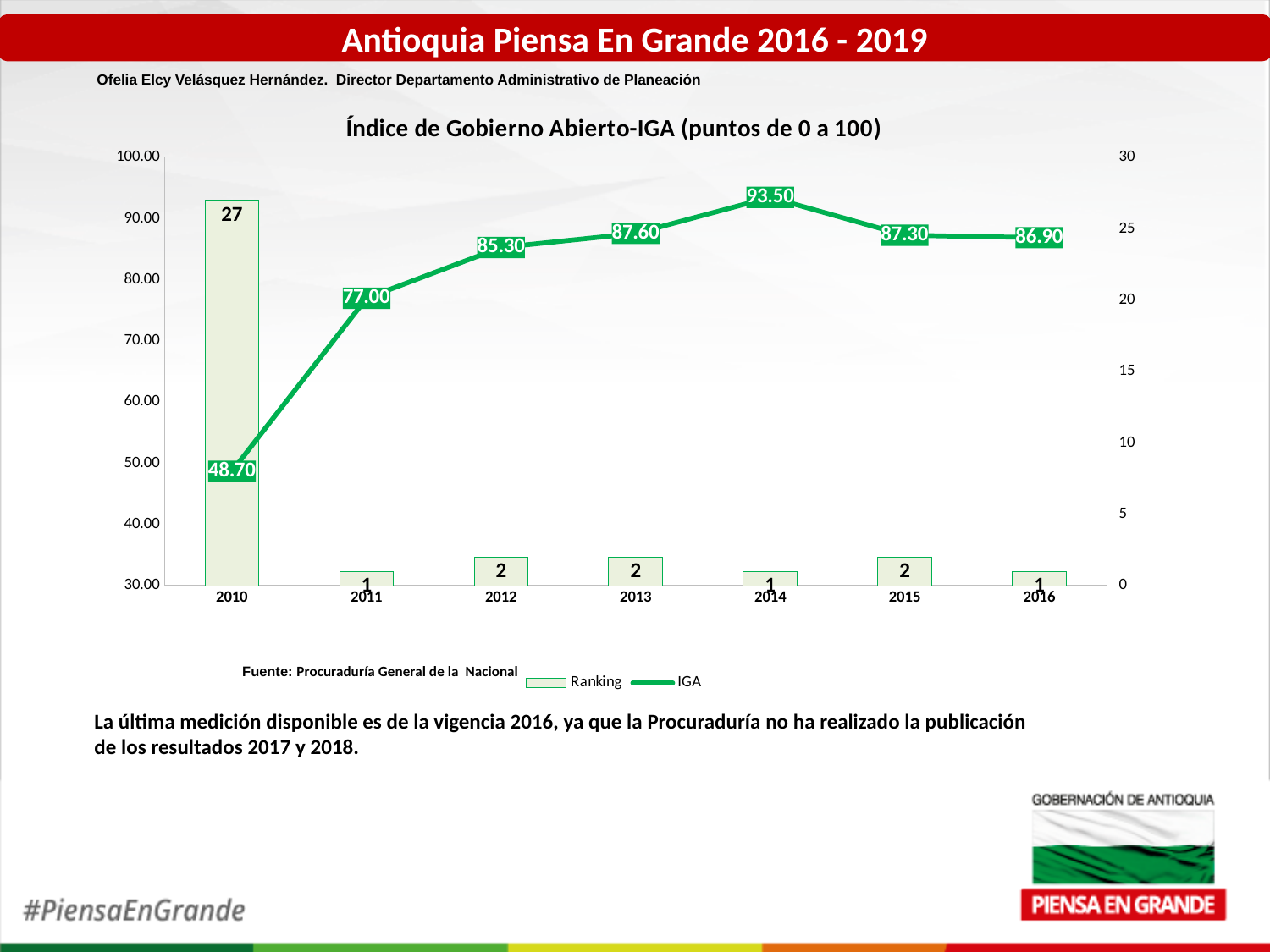
What is the IGA value for 2010? 48.70 Which is larger, the IGA value for 2013 or the IGA value for 2015? 2013 What is the Ranking value for 2010? 27 In which year is the IGA value highest? 2014 What is the Ranking value for 2016? 1 How many years are shown on the x axis? 7 Does the IGA value rise or fall from 2010 to 2014? rise How many series does the legend list? 2 In which year is the IGA value lowest? 2010 What is the title of the chart? Índice de Gobierno Abierto-IGA (puntos de 0 a 100) What is the difference between the IGA value in 2014 and the IGA value in 2010? 44.80 What is the IGA value for 2014? 93.50